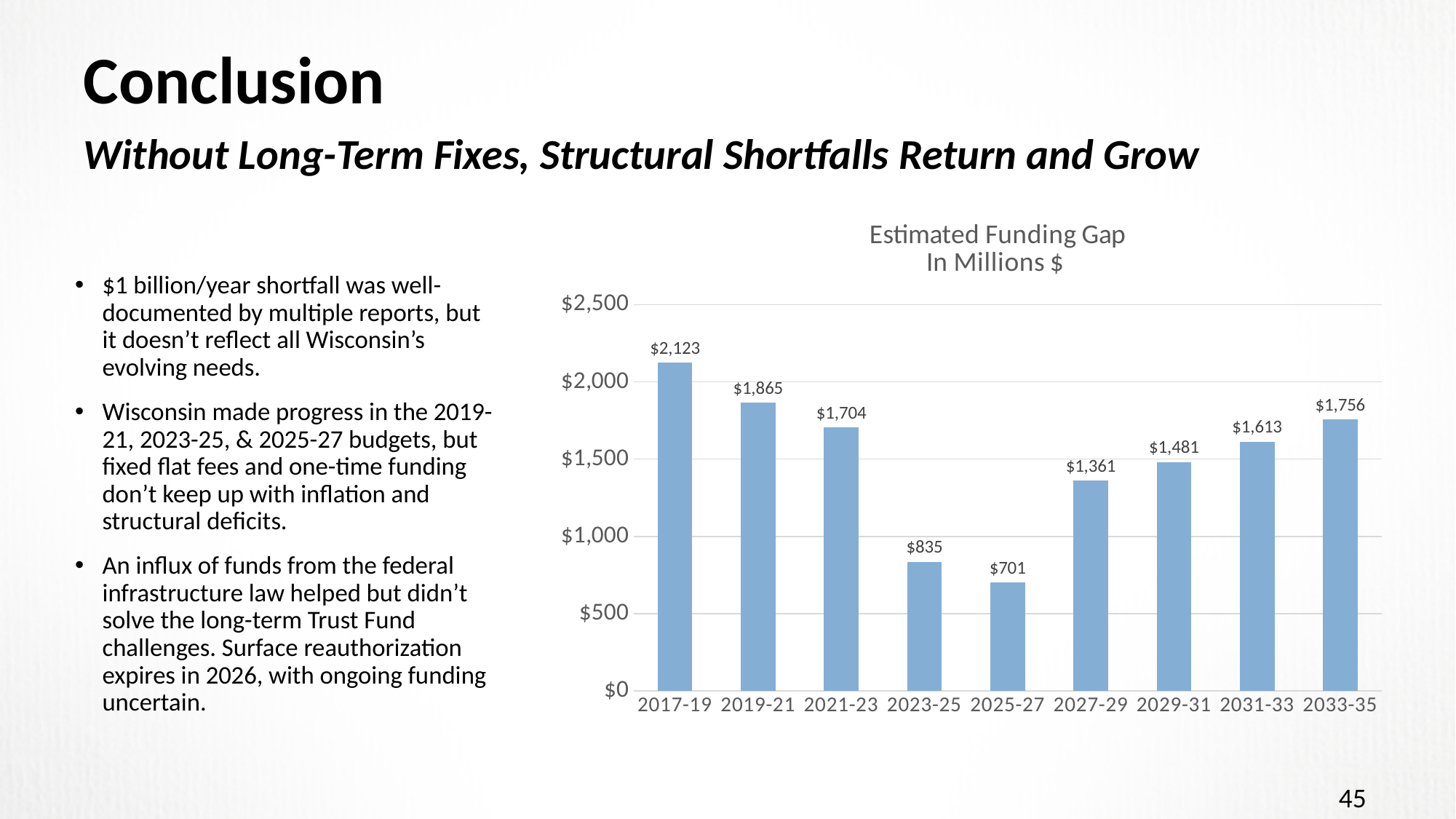
What is the title of the chart? Estimated Funding Gap In Millions $ What is the estimated funding gap for 2025-27? $701 What is the difference between the estimated funding gap for 2033-35 and 2031-33? $143 Is the estimated funding gap for 2023-25 greater or less than $1,000? less What is the estimated funding gap for 2017-19? $2,123 Which is larger, the estimated funding gap for 2019-21 or for 2033-35? 2019-21 Which period has the highest estimated funding gap? 2017-19 Which period has the lowest estimated funding gap? 2025-27 How many periods are shown on the x axis of the chart? 9 What is the estimated funding gap for 2033-35? $1,756 What is the difference between the estimated funding gap for 2017-19 and 2025-27? $1,422 What kind of chart is shown on the slide? bar chart